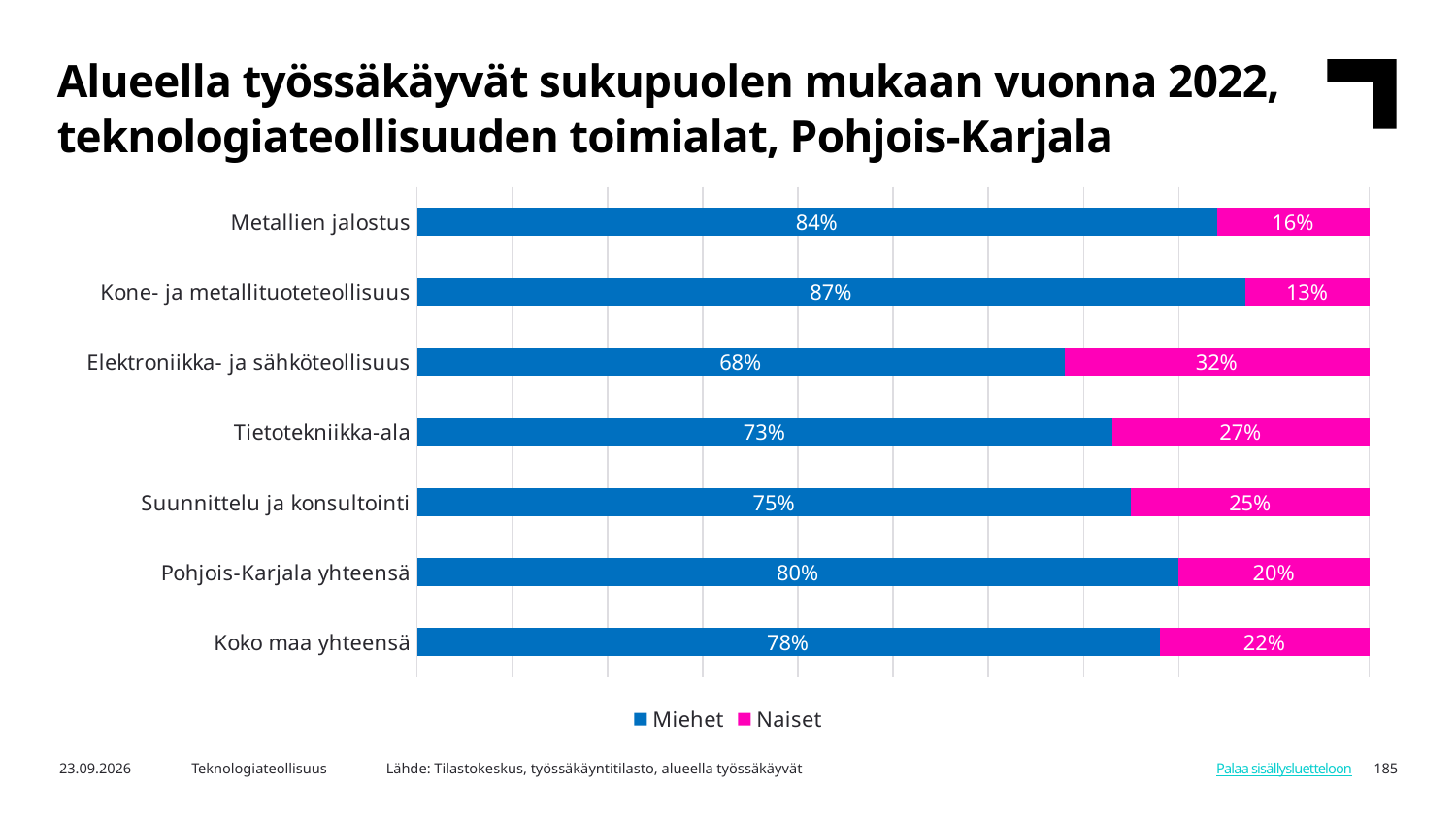
What is the difference between the Miehet share for Pohjois-Karjala yhteensä and Koko maa yhteensä? 2 percentage points Which category has the highest Miehet share? Kone- ja metallituoteteollisuus What kind of chart is shown on the slide? Stacked bar chart Which category has the lowest Naiset share? Kone- ja metallituoteteollisuus What is the Miehet share for Metallien jalostus? 84% Which colour represents Naiset in the chart? Magenta (pink) How many categories are shown on the chart? 7 How many series does the legend list? 2 What is the Naiset share for Koko maa yhteensä? 22% Which is larger: the Naiset share for Tietotekniikka-ala or for Suunnittelu ja konsultointi? Tietotekniikka-ala What is the total of the stacked bar for Tietotekniikka-ala? 100% What is the Naiset share for Elektroniikka- ja sähköteollisuus? 32%